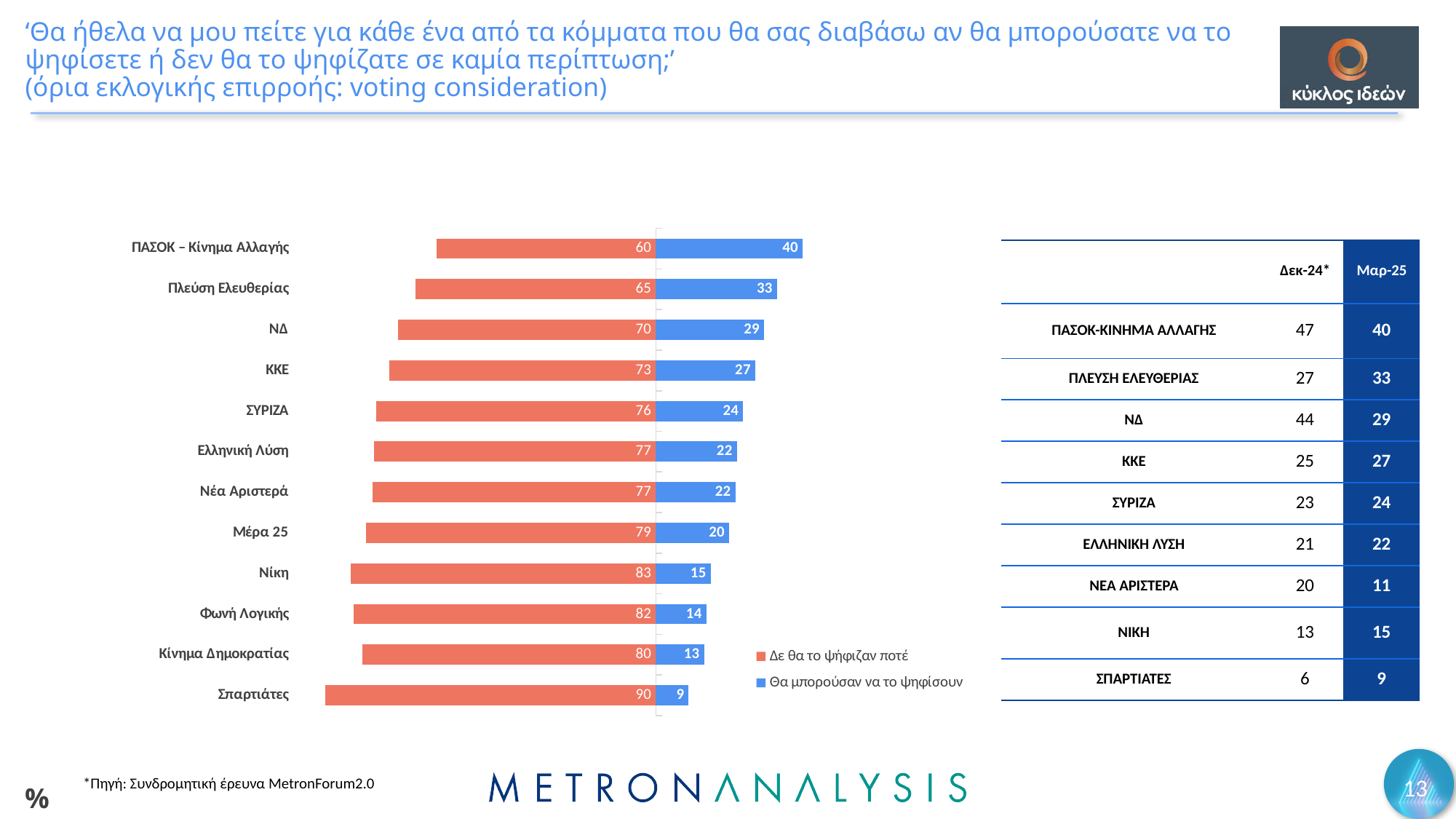
Which party has the lowest value for 'Θα μπορούσαν να το ψηφίσουν'? Σπαρτιάτες Which party has the highest value for 'Θα μπορούσαν να το ψηφίσουν'? ΠΑΣΟΚ – Κίνημα Αλλαγής How many parties are shown in the bar chart? 12 What is the value of 'Δε θα το ψήφιζαν ποτέ' for ΚΚΕ? 73 Which party has the lowest value for 'Δε θα το ψήφιζαν ποτέ'? ΠΑΣΟΚ – Κίνημα Αλλαγής What is the difference between the 'Θα μπορούσαν να το ψηφίσουν' values for Πλεύση Ελευθερίας and ΝΔ? 4 How many series does the chart legend list? 2 Which colour represents 'Δε θα το ψήφιζαν ποτέ' in the chart? Red What is the value of 'Θα μπορούσαν να το ψηφίσουν' for ΠΑΣΟΚ – Κίνημα Αλλαγής? 40 Which is larger: the 'Δε θα το ψήφιζαν ποτέ' value for Νίκη or for Φωνή Λογικής? Νίκη What type of chart is shown on the slide? Bar chart What is the value of 'Δε θα το ψήφιζαν ποτέ' for Σπαρτιάτες? 90